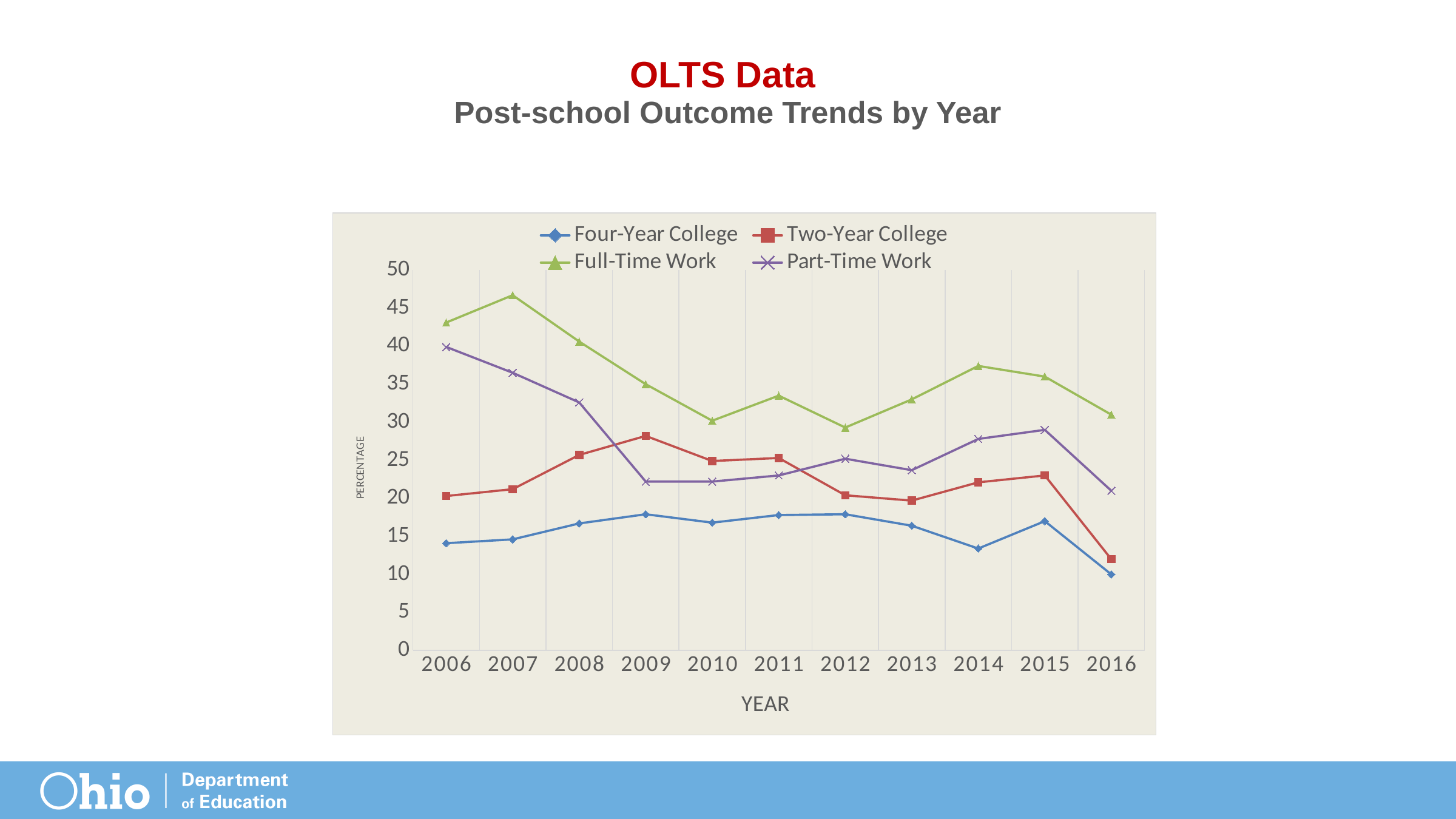
How many years are plotted along the x axis? 11 Is the value for Full-Time Work in 2006 greater or less than 40? greater In which year is the Full-Time Work value highest? 2007 Is the value for Part-Time Work in 2009 greater or less than 25? less How many series does the legend list? 4 What is the title of the x axis? YEAR What kind of chart is shown on the slide? line chart Does the Full-Time Work line rise or fall from 2007 to 2010? fall In which year is the Four-Year College value lowest? 2016 In 2009, which is larger: Two-Year College or Part-Time Work? Two-Year College Is the value for Two-Year College in 2016 greater or less than 15? less Which series has the highest value in 2016? Full-Time Work